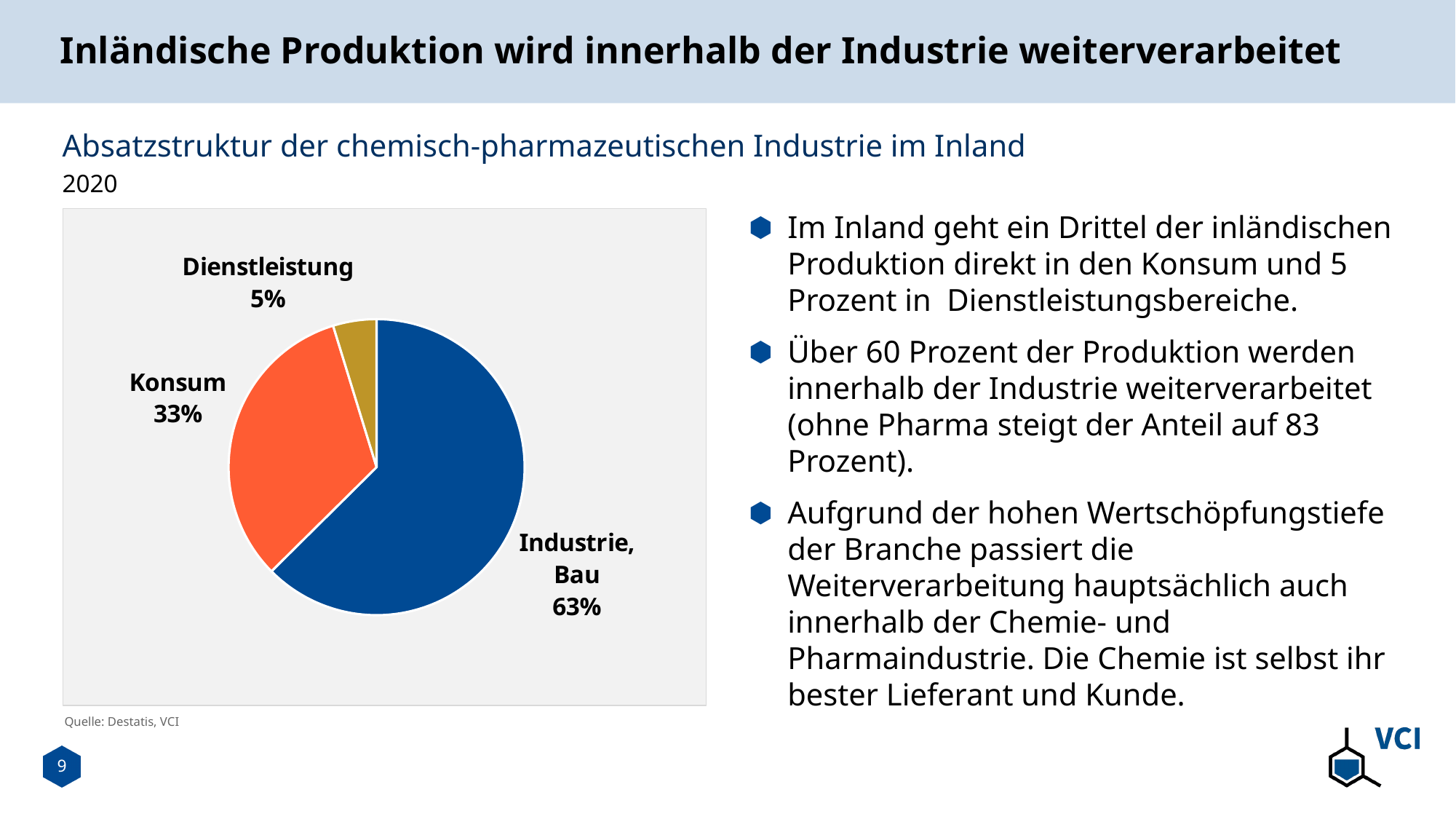
What is the title of the chart? Absatzstruktur der chemisch-pharmazeutischen Industrie im Inland What share of the pie does Industrie, Bau account for? 63% Which year does the chart refer to? 2020 Which category has the smallest share of the pie? Dienstleistung Which category has the largest share of the pie? Industrie, Bau What kind of chart is shown on the slide? Pie chart Which is larger, the share for Konsum or the share for Dienstleistung? Konsum What is the combined share of Konsum and Dienstleistung? 38% What share of the pie does Konsum account for? 33% What is the difference in percentage points between the Industrie, Bau share and the Konsum share? 30 percentage points What share of the pie does Dienstleistung account for? 5% How many categories are shown in the pie chart? 3